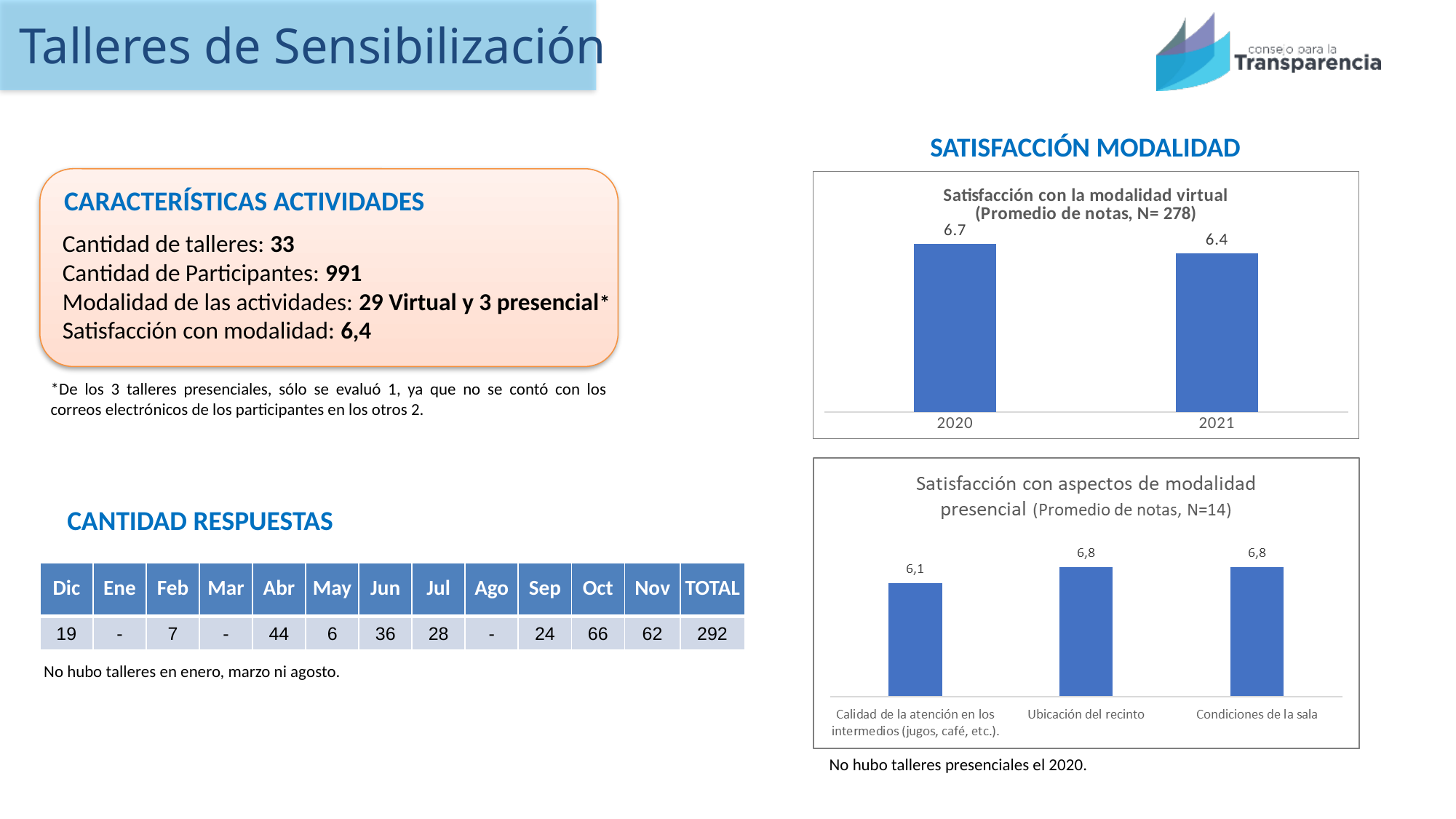
In the 'Satisfacción con la modalidad virtual' chart, what is the difference between the 2020 and 2021 values? 0.3 In the 'Satisfacción con la modalidad virtual' chart, what is the value for 2020? 6.7 How many categories are shown in the 'Satisfacción con aspectos de modalidad presencial' chart? 3 In the 'Satisfacción con aspectos de modalidad presencial' chart, what is the value for 'Ubicación del recinto'? 6,8 How many bars are shown in the 'Satisfacción con la modalidad virtual' chart? 2 In the 'Satisfacción con aspectos de modalidad presencial' chart, which category has the lowest value? Calidad de la atención en los intermedios (jugos, café, etc.) What is the N value stated in the title of the 'Satisfacción con la modalidad virtual' chart? 278 In the 'Satisfacción con la modalidad virtual' chart, what is the value for 2021? 6.4 In the 'Satisfacción con la modalidad virtual' chart, which year has the higher value? 2020 In the 'Satisfacción con aspectos de modalidad presencial' chart, what is the value for 'Calidad de la atención en los intermedios (jugos, café, etc.)'? 6,1 In the 'Satisfacción con la modalidad virtual' chart, do the values rise or fall from 2020 to 2021? fall What type of chart is the 'Satisfacción con aspectos de modalidad presencial' chart? bar chart